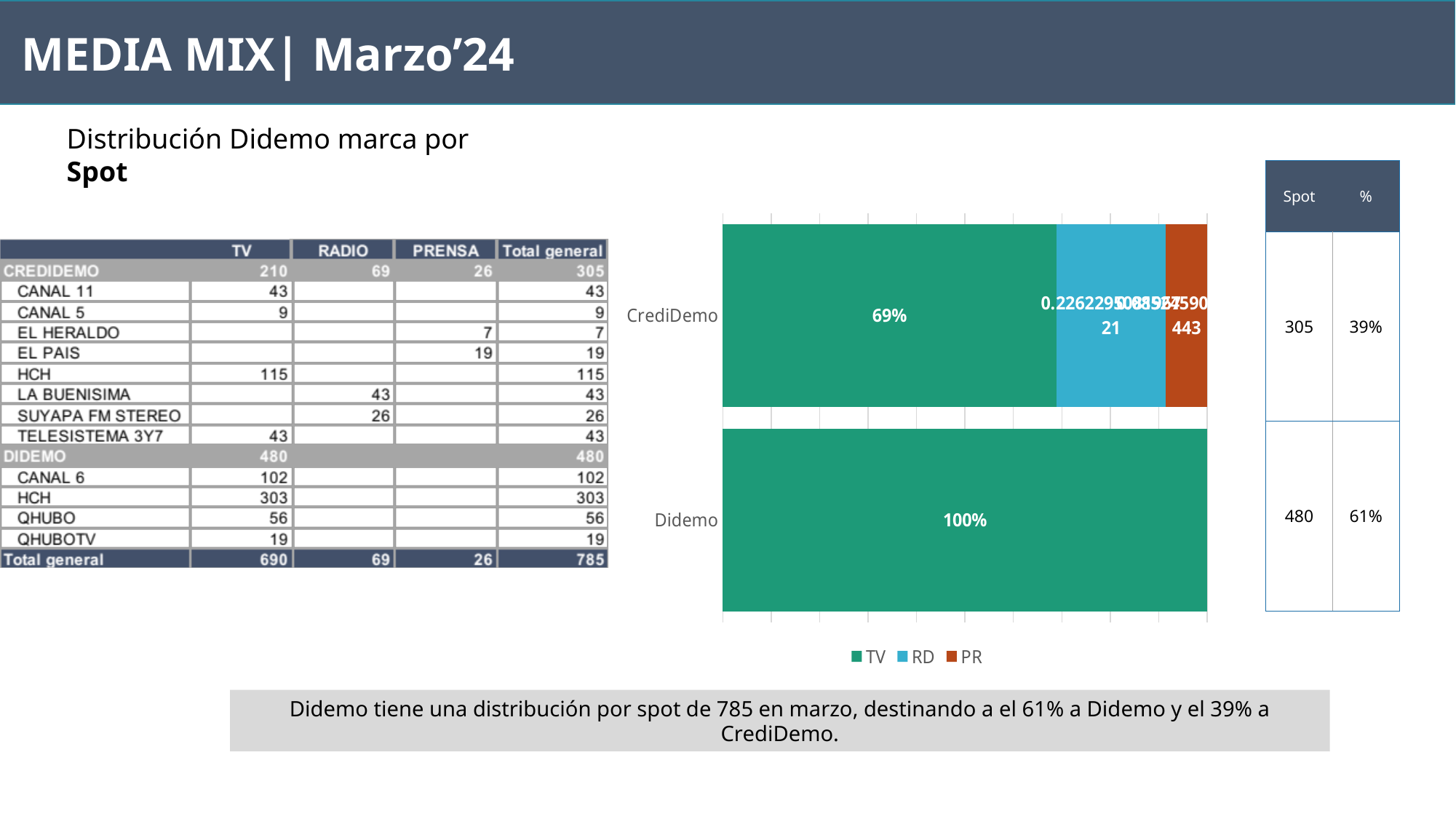
Which category has the highest TV share in the chart? Didemo How many categories (bars) does the chart show? 2 Which series forms the largest segment of the CrediDemo bar? TV What percentage label is shown on the TV segment of the Didemo bar? 100% Which category has the larger TV share, CrediDemo or Didemo? Didemo What are the series names listed in the chart legend? TV, RD, PR What kind of chart is shown on the slide? bar chart How many series does the chart legend list? 3 What percentage label is shown on the TV segment of the CrediDemo bar? 69% Which category's bar is made up of only one series? Didemo Which series forms the smallest segment of the CrediDemo bar? PR Which category has the lowest TV share in the chart? CrediDemo